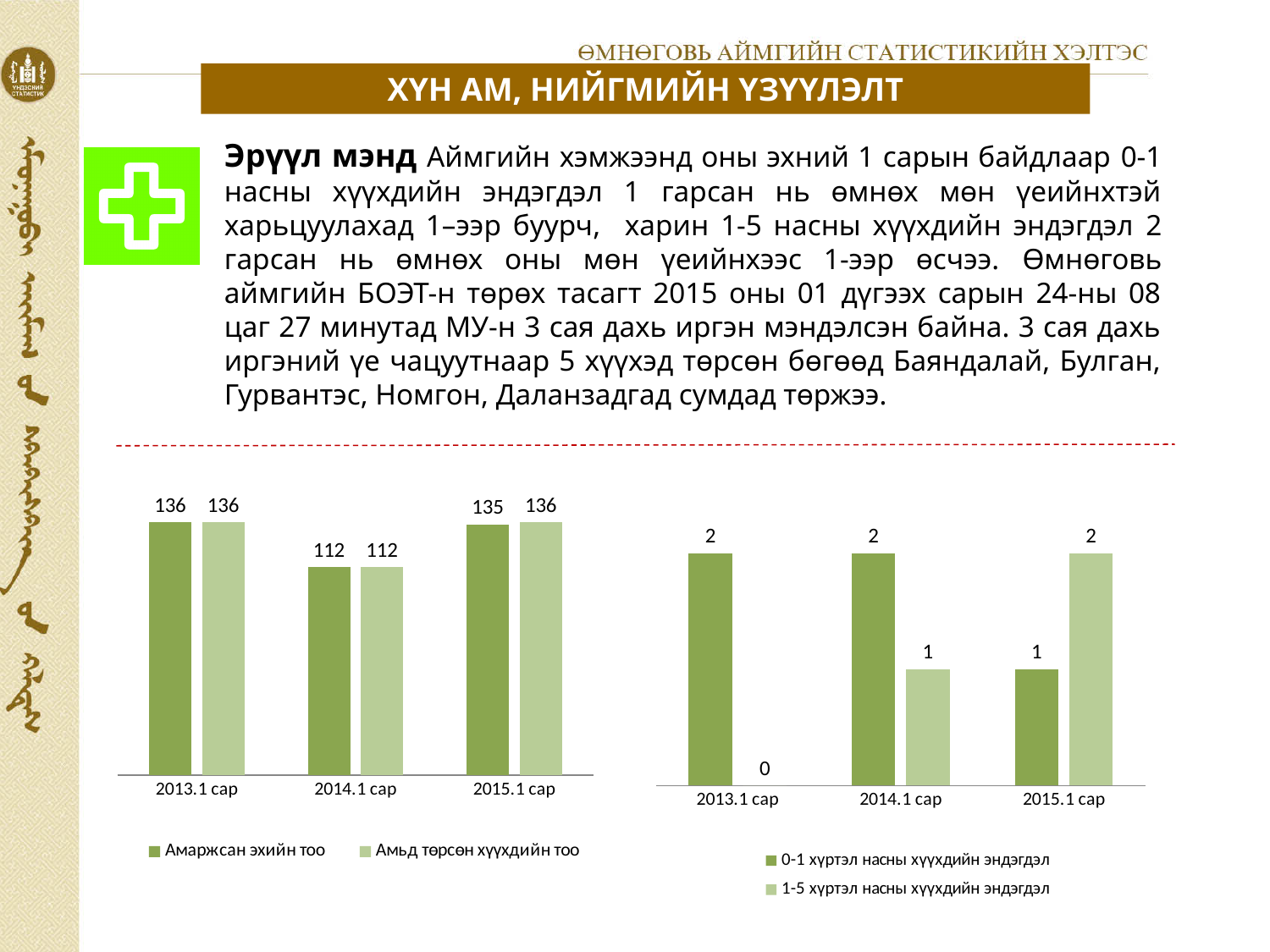
In the right chart, what is the value of 1-5 хүртэл насны хүүхдийн эндэгдэл for 2013.1 сар? 0 In the left chart, which category has the lowest value for Амаржсан эхийн тоо? 2014.1 сар In the right chart, what is the value of 0-1 хүртэл насны хүүхдийн эндэгдэл for 2015.1 сар? 1 In the left chart, what is the value of Амаржсан эхийн тоо for 2014.1 сар? 112 In the right chart, what is the difference between 1-5 хүртэл насны хүүхдийн эндэгдэл in 2015.1 сар and 2014.1 сар? 1 In the left chart, what is the difference between Амьд төрсөн хүүхдийн тоо and Амаржсан эхийн тоо for 2015.1 сар? 1 In the left chart, what is the value of Амьд төрсөн хүүхдийн тоо for 2015.1 сар? 136 How many categories are shown on the x axis of the right chart? 3 In the right chart, does the value of 1-5 хүртэл насны хүүхдийн эндэгдэл rise or fall from 2013.1 сар to 2015.1 сар? rise In the left chart, how many series does the legend list? 2 What kind of chart is the left chart? bar chart In the right chart, which is larger for 2014.1 сар: 0-1 хүртэл насны хүүхдийн эндэгдэл or 1-5 хүртэл насны хүүхдийн эндэгдэл? 0-1 хүртэл насны хүүхдийн эндэгдэл